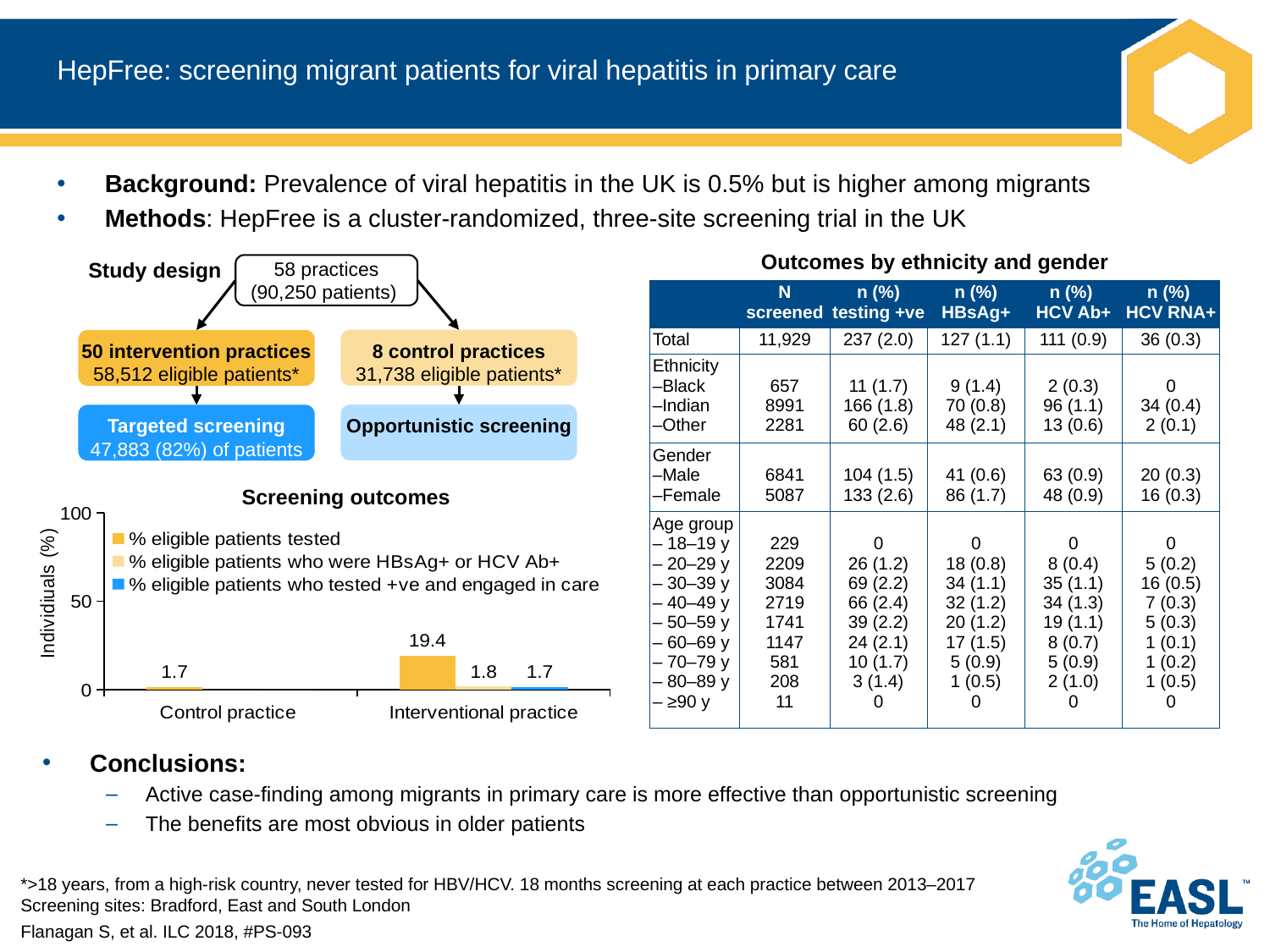
In the Screening outcomes chart, what is the value of % eligible patients tested for Interventional practice? 19.4 In the Screening outcomes chart, what is the value of % eligible patients tested for Control practice? 1.7 In the Screening outcomes chart, how many practice categories are shown on the x axis? 2 In the Screening outcomes chart, which practice type has the higher value for % eligible patients tested? Interventional practice In the Screening outcomes chart, what is the value of % eligible patients who tested +ve and engaged in care for Interventional practice? 1.7 What type of chart is the Screening outcomes chart? Bar chart In the Screening outcomes chart, how many series does the legend list? 3 In the Screening outcomes chart, what is the label of the y axis? Individuals (%) In the Screening outcomes chart, what is the difference in % eligible patients tested between Interventional practice and Control practice? 17.7 In the Screening outcomes chart, is the value of % eligible patients tested for Interventional practice greater or less than 50? less In the Screening outcomes chart, what is the value of % eligible patients who were HBsAg+ or HCV Ab+ for Interventional practice? 1.8 In the Screening outcomes chart, which series is shown in blue? % eligible patients who tested +ve and engaged in care